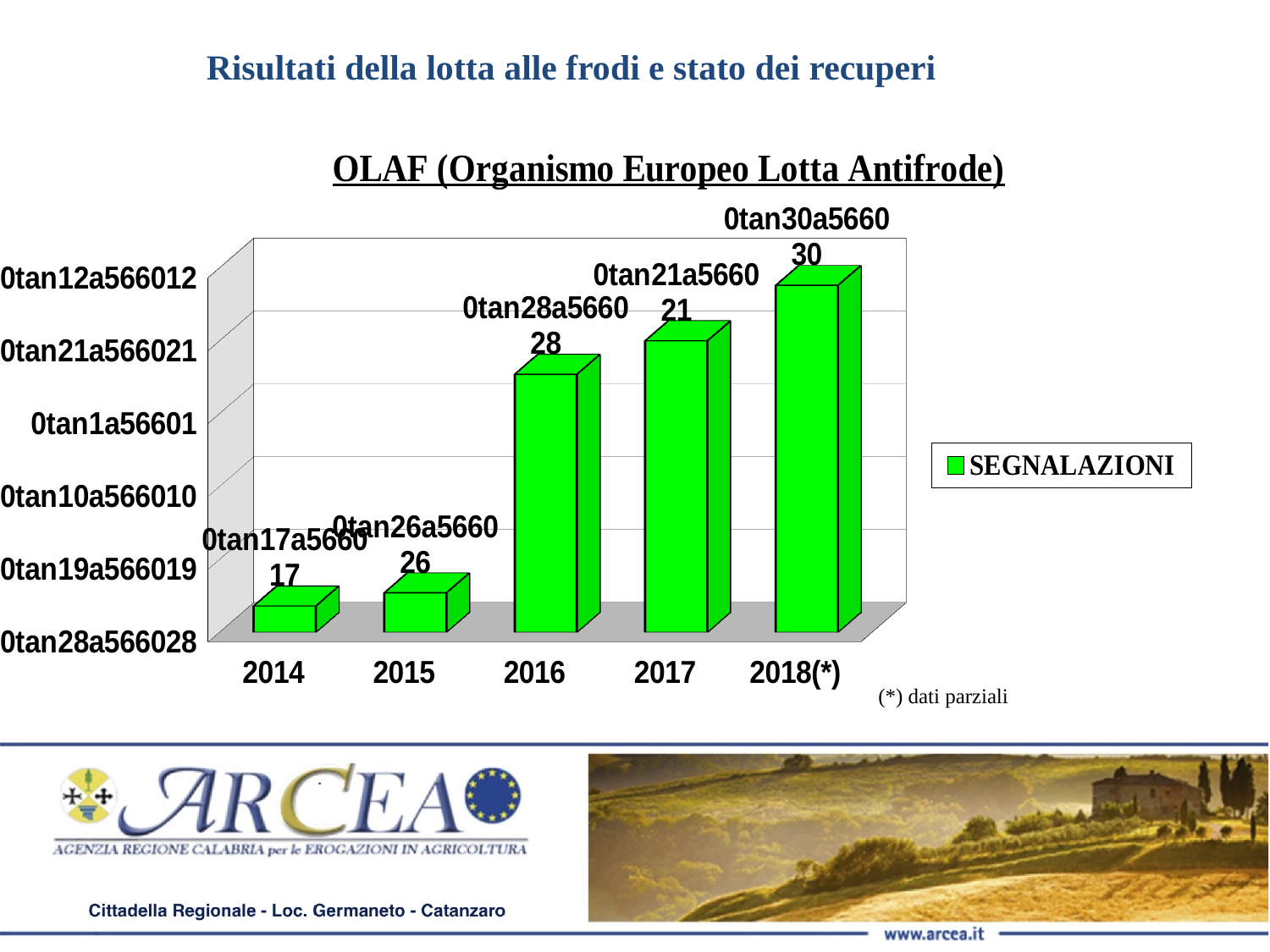
Which year has the tallest bar in the chart? 2018(*) Which bar is taller, 2016 or 2015? 2016 Which bar is taller, 2015 or 2018(*)? 2018(*) Which year has the shortest bar in the chart? 2014 What is the first year shown on the x axis? 2014 What is the name of the series shown in the chart legend? SEGNALAZIONI What kind of chart is shown on the slide? bar chart How many series does the chart legend list? 1 How many years are shown on the x axis of the chart? 5 What is the title of the chart? OLAF (Organismo Europeo Lotta Antifrode) Which bar is taller, 2016 or 2014? 2016